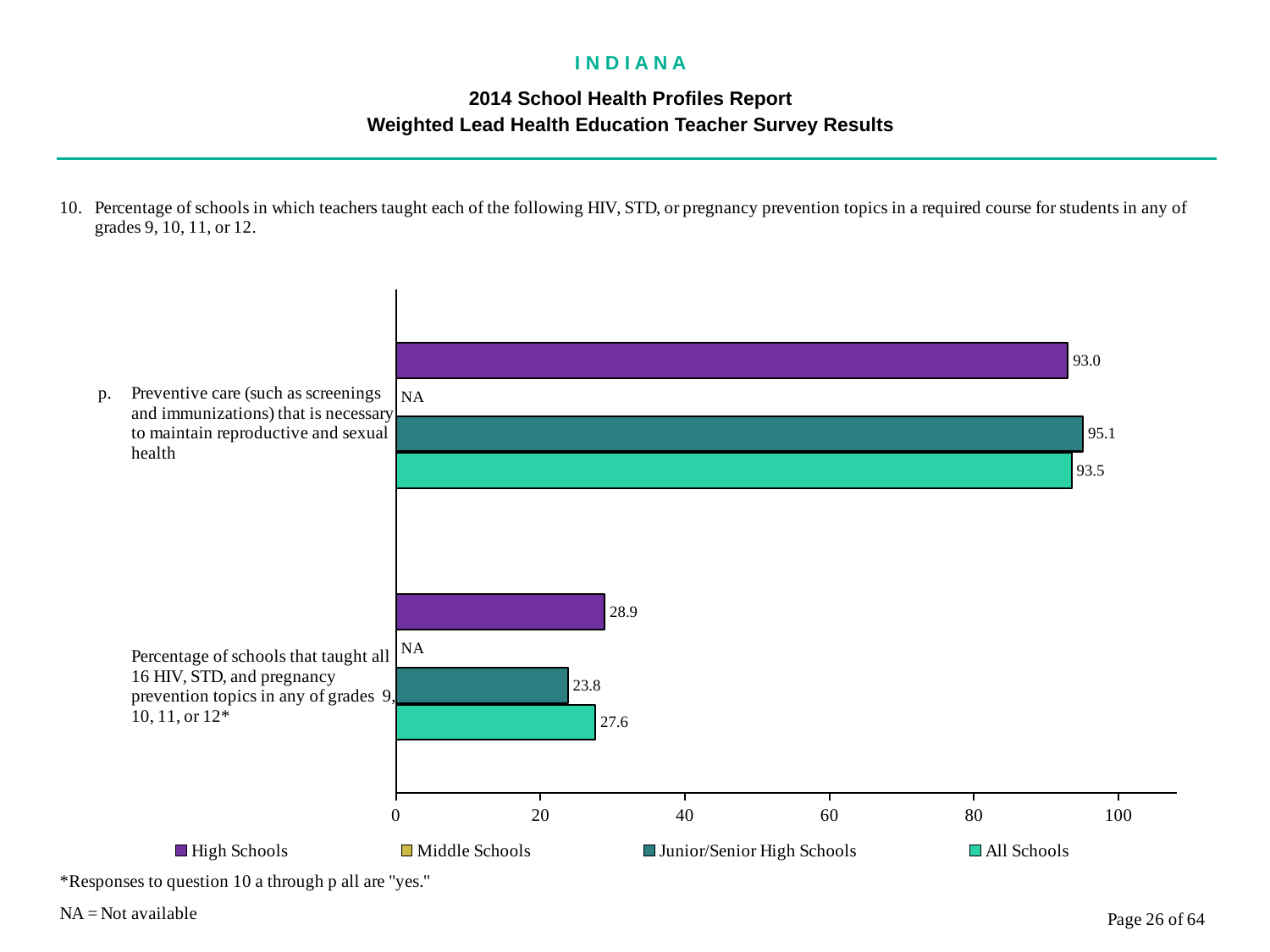
What is the difference between the High Schools and Junior/Senior High Schools values for the percentage of schools that taught all 16 topics? 5.1 What value is shown for Middle Schools for the preventive care topic (item p)? NA For the preventive care topic (item p), which is larger: the All Schools value or the High Schools value? All Schools How many series does the legend list? 4 What is the value for High Schools for the preventive care topic (item p)? 93.0 What kind of chart is shown on the slide? Bar chart What is the value for Junior/Senior High Schools for the preventive care topic (item p)? 95.1 What colour are the High Schools bars? Purple Which series has the lowest value for the percentage of schools that taught all 16 topics? Junior/Senior High Schools What is the value for All Schools for the percentage of schools that taught all 16 HIV, STD, and pregnancy prevention topics? 27.6 What is the value for Junior/Senior High Schools for the percentage of schools that taught all 16 HIV, STD, and pregnancy prevention topics? 23.8 Which series has the highest value for the preventive care topic (item p)? Junior/Senior High Schools